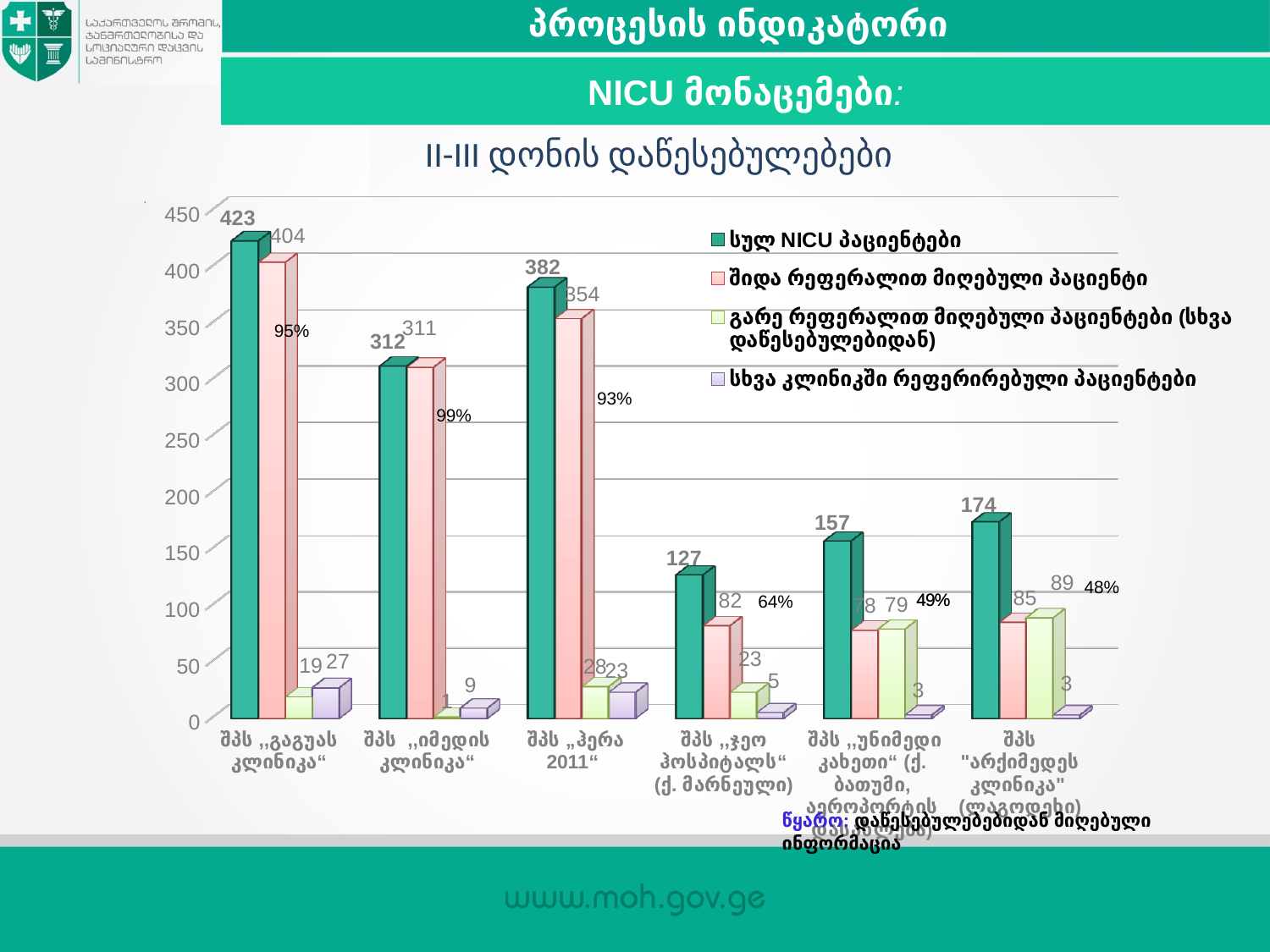
Which clinic has the highest value for სულ NICU პაციენტები? შპს „გაგუას კლინიკა“ Which is larger for შპს „არქიმედეს კლინიკა“: სულ NICU პაციენტები or შიდა რეფერალით მიღებული პაციენტი? სულ NICU პაციენტები What is the title shown above the chart? II-III დონის დაწესებულებები What percentage is shown next to the bars for შპს „იმედის კლინიკა“? 99% Which clinic has the lowest value for სულ NICU პაციენტები? შპს „ჯეო ჰოსპიტალს“ (ქ. მარნეული) How many series does the legend list? 4 What type of chart is shown on the slide? bar chart What is the value of სულ NICU პაციენტები for შპს „გაგუას კლინიკა“? 423 How many clinics (categories) are shown on the x axis? 6 What is the difference between სულ NICU პაციენტები and შიდა რეფერალით მიღებული პაციენტი for შპს „ჯეო ჰოსპიტალს“ (ქ. მარნეული)? 45 What is the value of გარე რეფერალით მიღებული პაციენტები for შპს „უნიმედი კახეთი“? 79